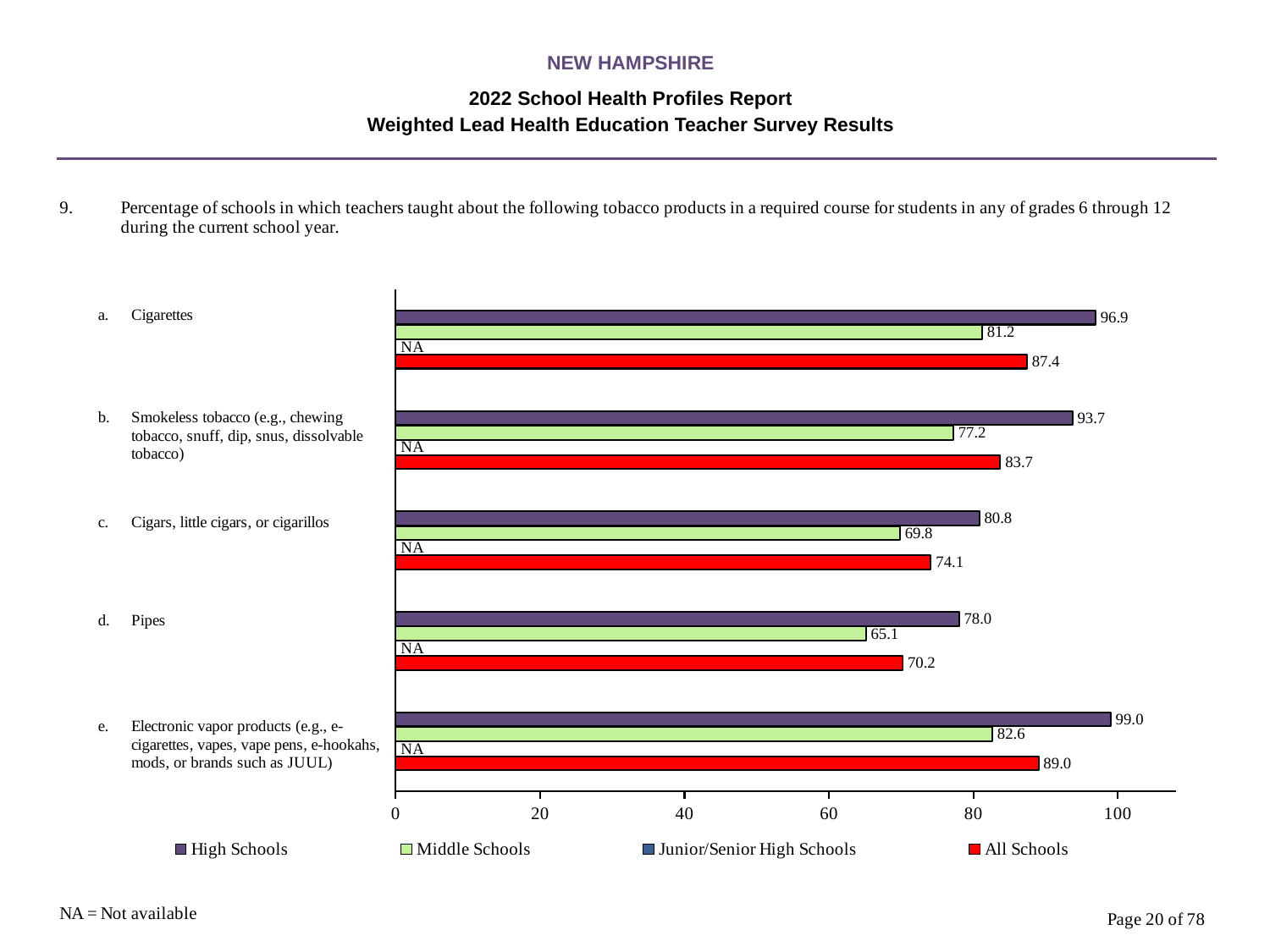
What is the difference between the High Schools and Middle Schools values for Cigars, little cigars, or cigarillos? 11.0 Which category has the highest High Schools value? Electronic vapor products What kind of chart is shown on the slide? bar chart Which is larger: the All Schools value for Cigarettes or the All Schools value for Electronic vapor products? Electronic vapor products What is the Middle Schools value for Electronic vapor products? 82.6 What is the High Schools value for Cigarettes? 96.9 What value is shown for Junior/Senior High Schools in each category? NA What is the All Schools value for Smokeless tobacco? 83.7 How many series does the legend list? 4 How many tobacco product categories are shown on the chart? 5 Which category has the lowest All Schools value? Pipes What is the Middle Schools value for Pipes? 65.1